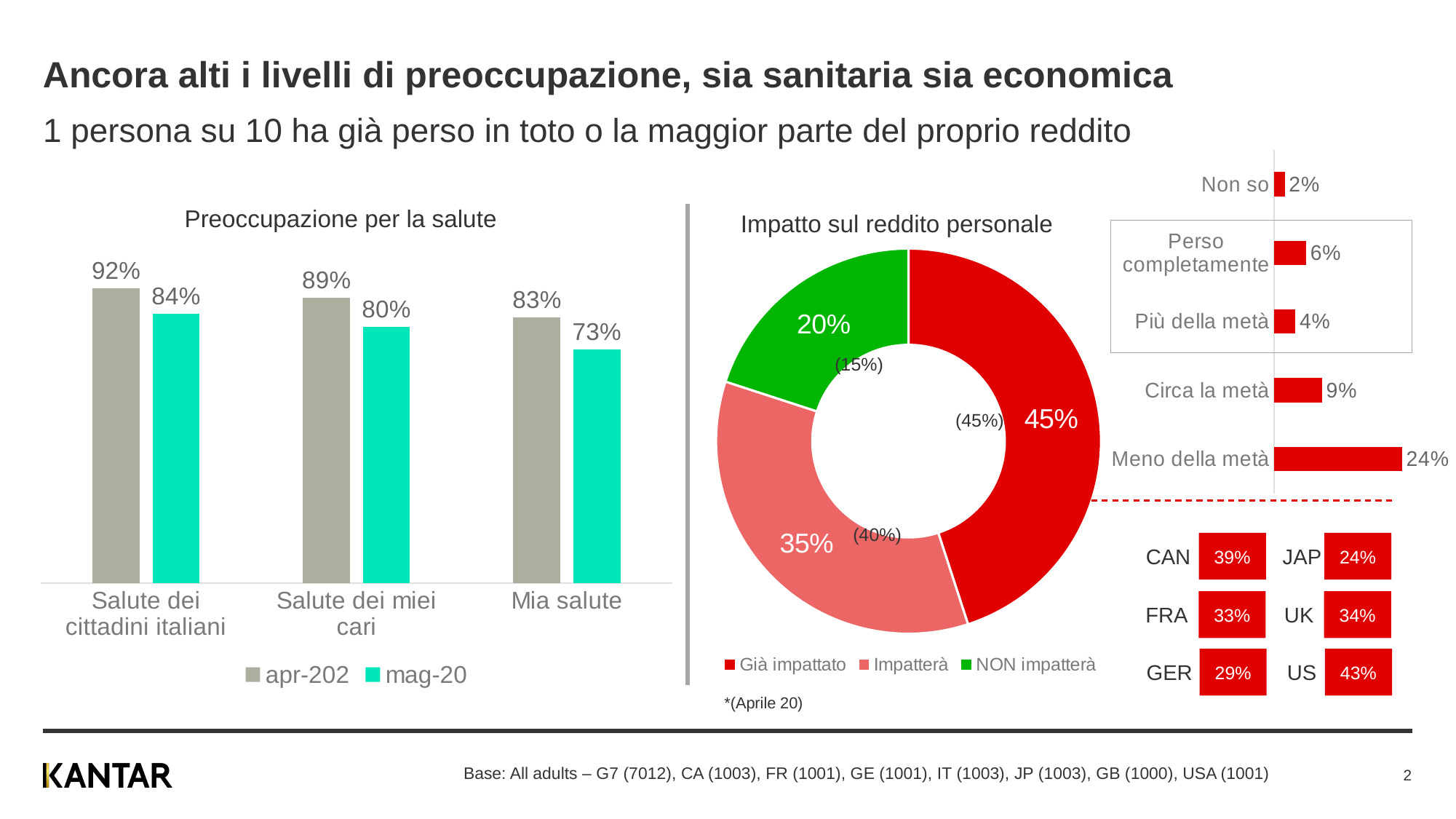
In the 'Preoccupazione per la salute' chart, how many series does the legend list? 2 In the 'Preoccupazione per la salute' chart, do the mag-20 values rise or fall from left to right across the categories? fall In the 'Preoccupazione per la salute' chart, which category has the highest apr-202 value? Salute dei cittadini italiani In the 'Impatto sul reddito personale' chart, what share is 'Già impattato'? 45% In the 'Preoccupazione per la salute' chart, what is the apr-202 value for 'Salute dei miei cari'? 89% In the horizontal bar chart on the right of the slide, which category has the lowest value? Non so In the 'Impatto sul reddito personale' chart, how many slices are there? 3 In the 'Impatto sul reddito personale' chart, which slice is the smallest? NON impatterà In the 'Preoccupazione per la salute' chart, what is the difference between the apr-202 and mag-20 values for 'Mia salute'? 10 percentage points In the horizontal bar chart on the right of the slide, what is the value for 'Meno della metà'? 24% In the 'Preoccupazione per la salute' chart, what is the value for 'Mia salute' in the mag-20 series? 73% What kind of chart is 'Preoccupazione per la salute'? bar chart